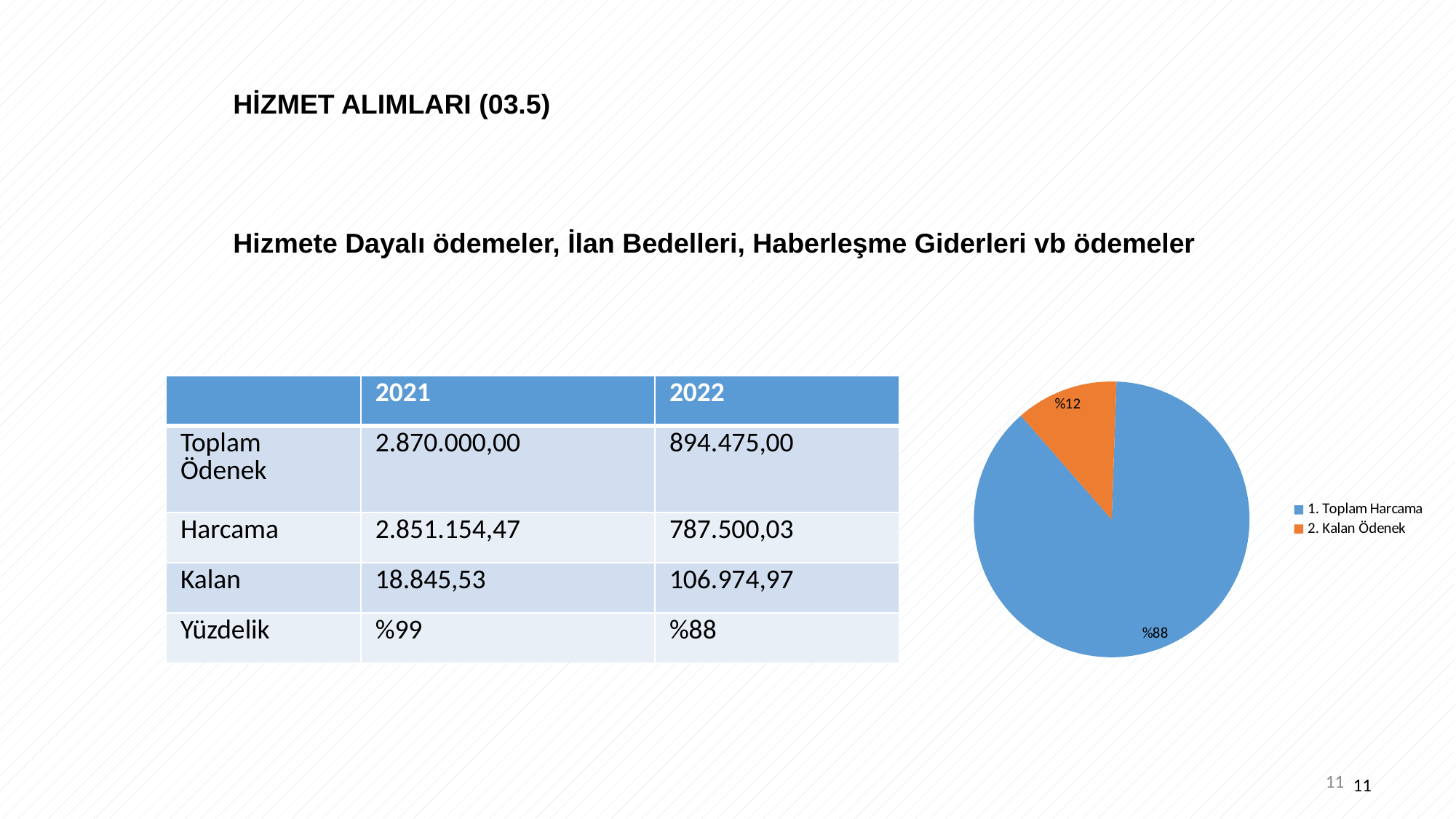
What share of the pie does "2. Kalan Ödenek" represent? %12 What is the difference in percentage points between the Toplam Harcama slice and the Kalan Ödenek slice? 76 What kind of chart is shown on the slide? pie chart What colour is the "2. Kalan Ödenek" slice in the pie chart? orange How many slices does the pie chart have? 2 What share of the pie does "1. Toplam Harcama" represent? %88 Which slice of the pie chart is the largest? 1. Toplam Harcama Which slice of the pie chart is the smallest? 2. Kalan Ödenek What colour is the "1. Toplam Harcama" slice in the pie chart? blue How many entries does the pie chart's legend list? 2 Which is larger in the pie chart, Toplam Harcama or Kalan Ödenek? Toplam Harcama